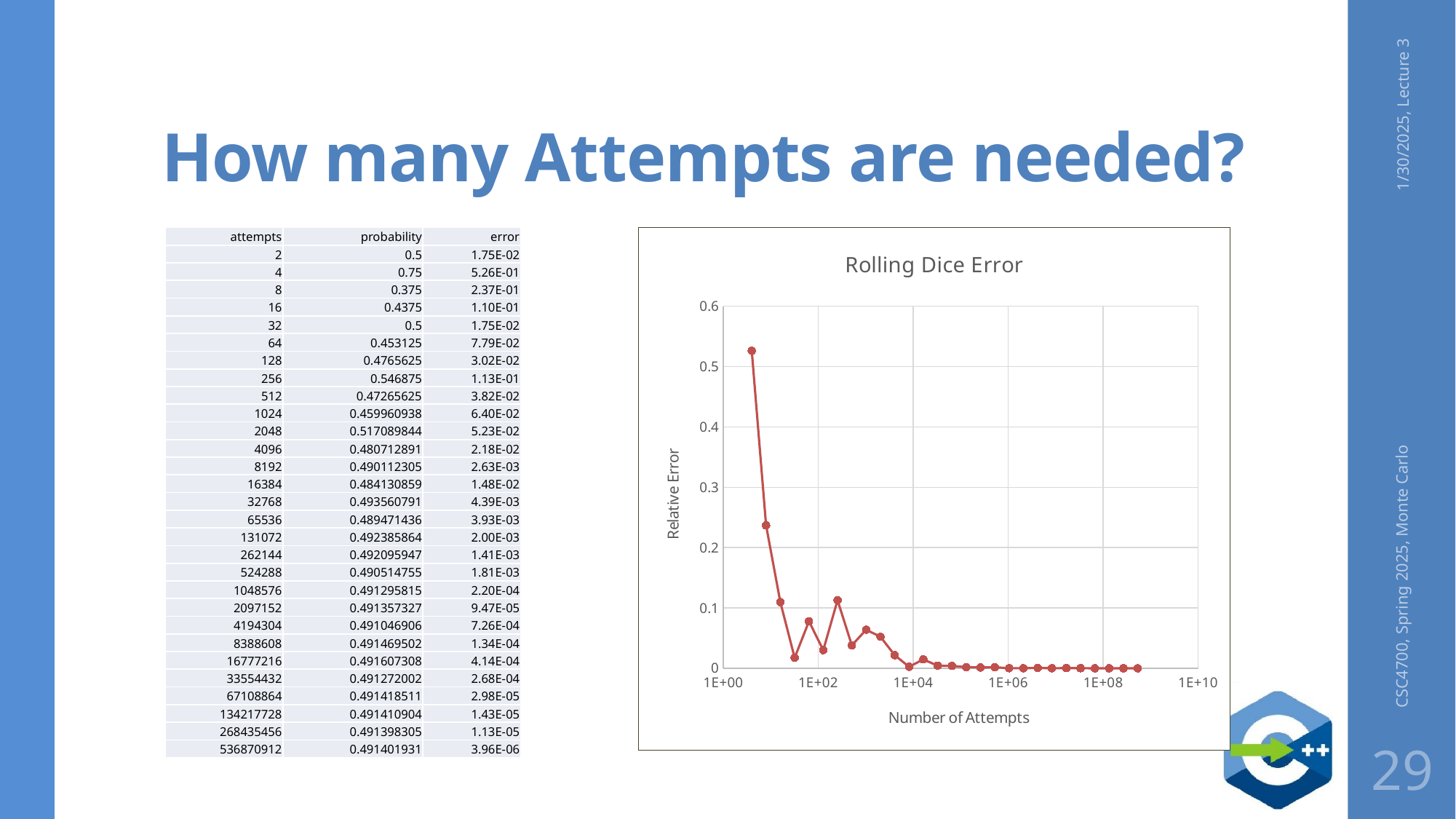
At which number of attempts is the relative error highest? 4 Is the relative error at 2 attempts greater or less than 0.1? less Is the relative error at 1E+06 attempts greater or less than 0.1? less Which has the larger relative error, 4 attempts or 8 attempts? 4 attempts What kind of chart is shown on the slide? line chart How many data points are plotted on the chart? 28 What is the label of the y axis of the chart? Relative Error Is the relative error at 4 attempts greater or less than 0.5? greater Which has the larger relative error, 256 attempts or 128 attempts? 256 attempts What is the title of the chart? Rolling Dice Error Overall, does the relative error rise or fall as the number of attempts increases? fall